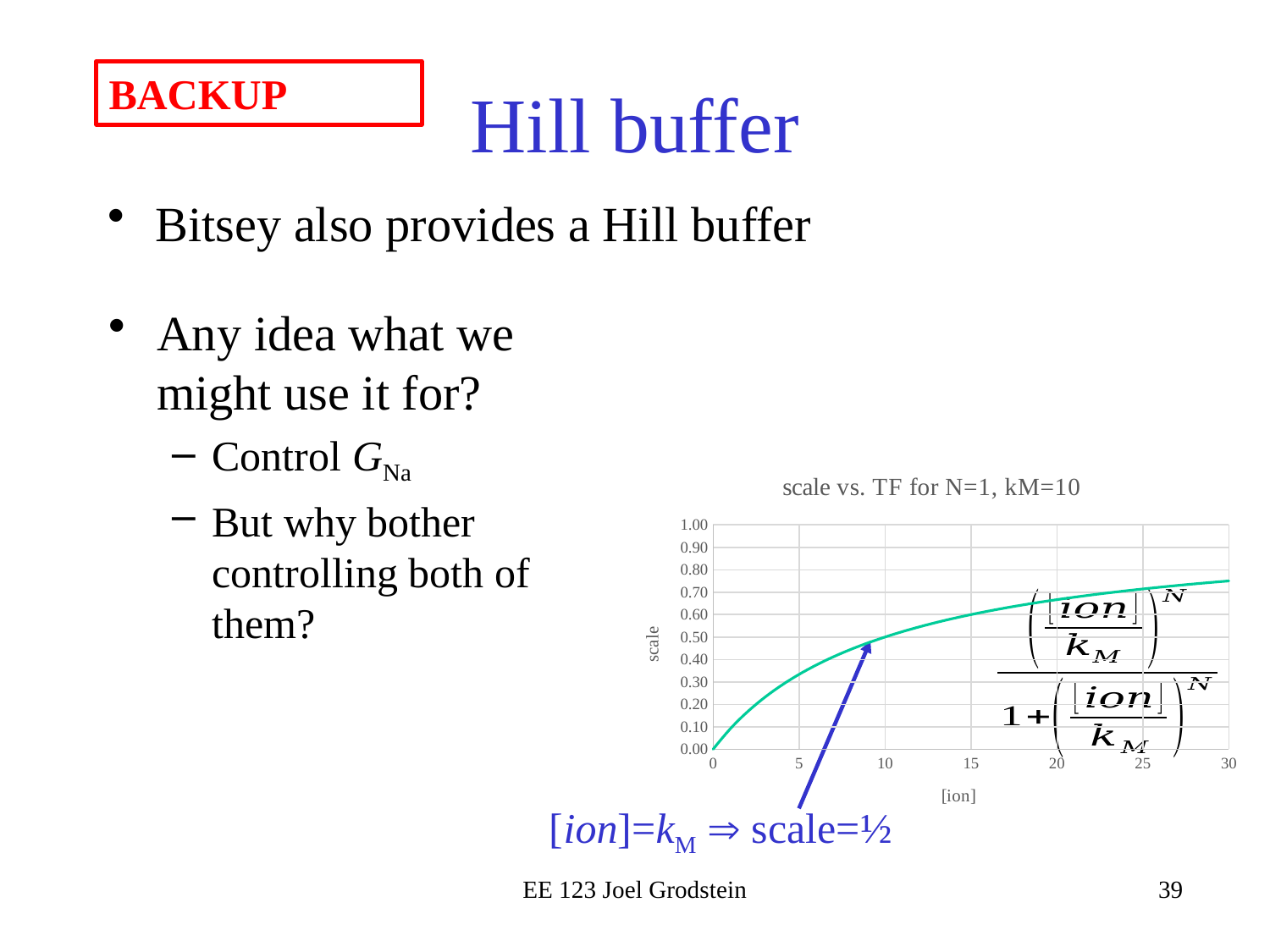
Is the scale value at [ion]=5 greater or less than 0.40? less What is the highest value shown on the x axis of the chart? 30 Is the scale value at [ion]=15 greater or less than 0.50? greater Which has the larger scale value, [ion]=10 or [ion]=25? [ion]=25 Is the scale value at [ion]=30 greater or less than 0.70? greater What is the title of the chart? scale vs. TF for N=1, kM=10 What is the label of the x axis of the chart? [ion] According to the annotation on the chart, what is the scale value when [ion] equals kM? ½ Does the scale value rise or fall as [ion] increases along the x axis? rise What kind of chart is shown on the slide? line chart